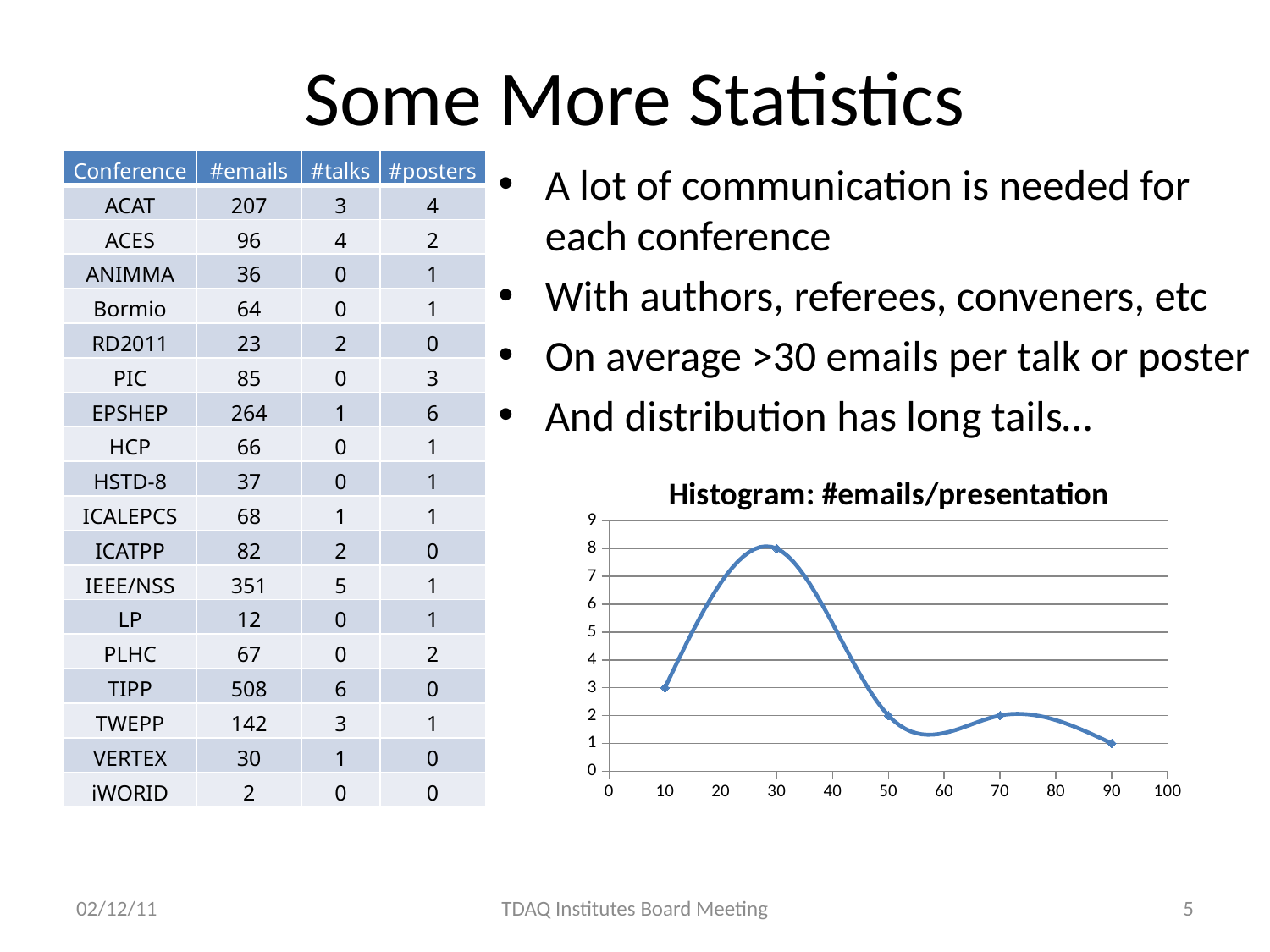
Does the line rise or fall between x = 30 and x = 90? fall What is the difference between the value at x = 30 and the value at x = 10? 5 What is the value of the point at x = 90? 1 At which x value does the line reach its lowest point? 90 Is the value at x = 30 greater or less than 5? greater At which x value does the line reach its highest point? 30 Which is larger, the value at x = 10 or the value at x = 50? x = 10 What kind of chart is shown on the slide? line chart How many data points are plotted on the chart? 5 What is the title of the chart? Histogram: #emails/presentation What is the value of the point at x = 10? 3 What is the value of the point at x = 30? 8